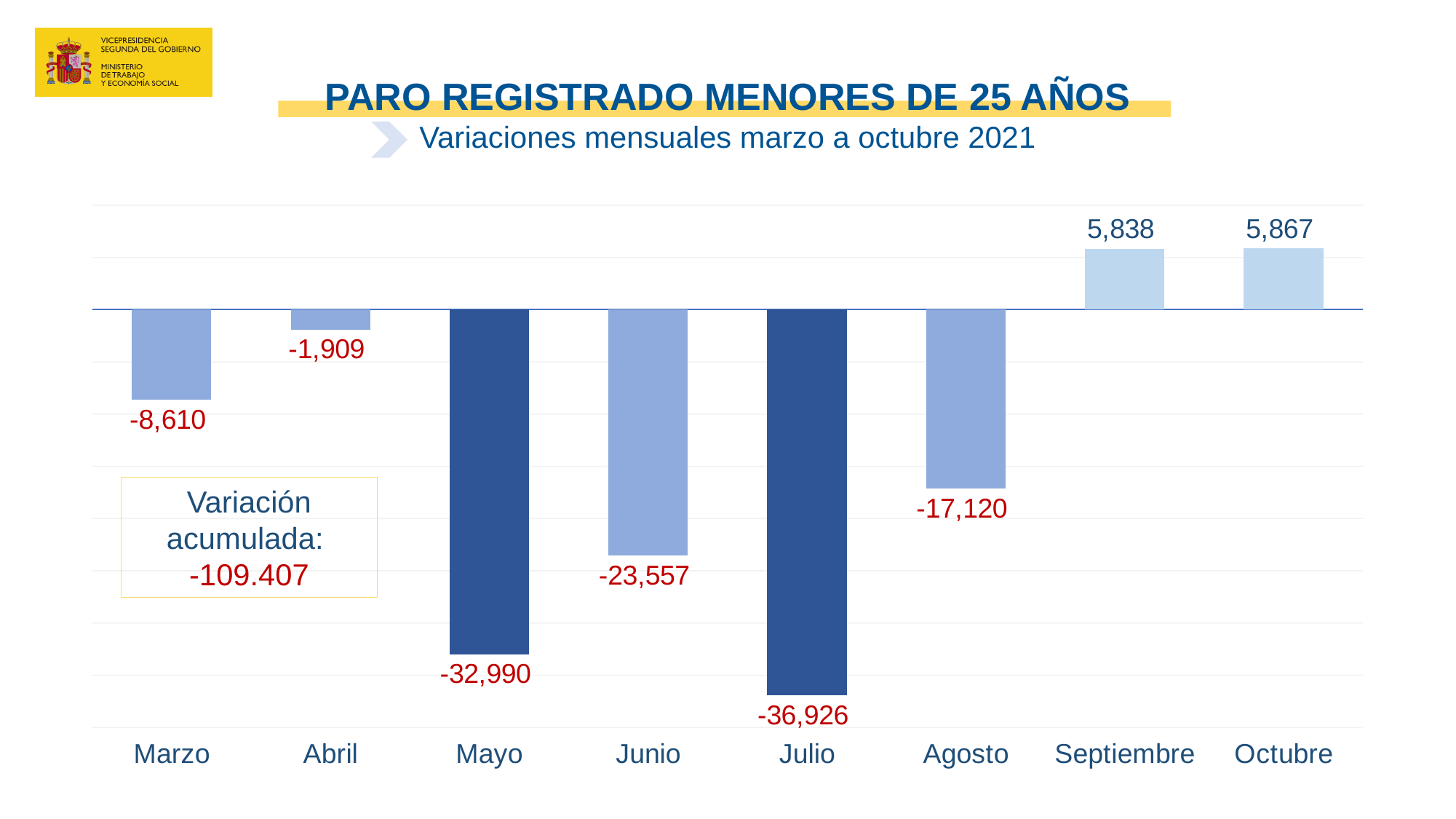
Which is larger, the value for Junio or the value for Agosto? Agosto How many months are shown on the x axis? 8 Which month has the highest value? Octubre What is the difference between the values for Julio and Mayo? 3,936 Which month has the lowest value? Julio Do the values rise or fall from Julio to Octubre? Rise What is the value for Mayo? -32,990 What is the value for Septiembre? 5,838 What is the difference between the values for Marzo and Abril? 6,701 What is the value for Agosto? -17,120 What kind of chart is shown on the slide? Bar chart What is the 'Variación acumulada' shown in the text box on the chart? -109.407